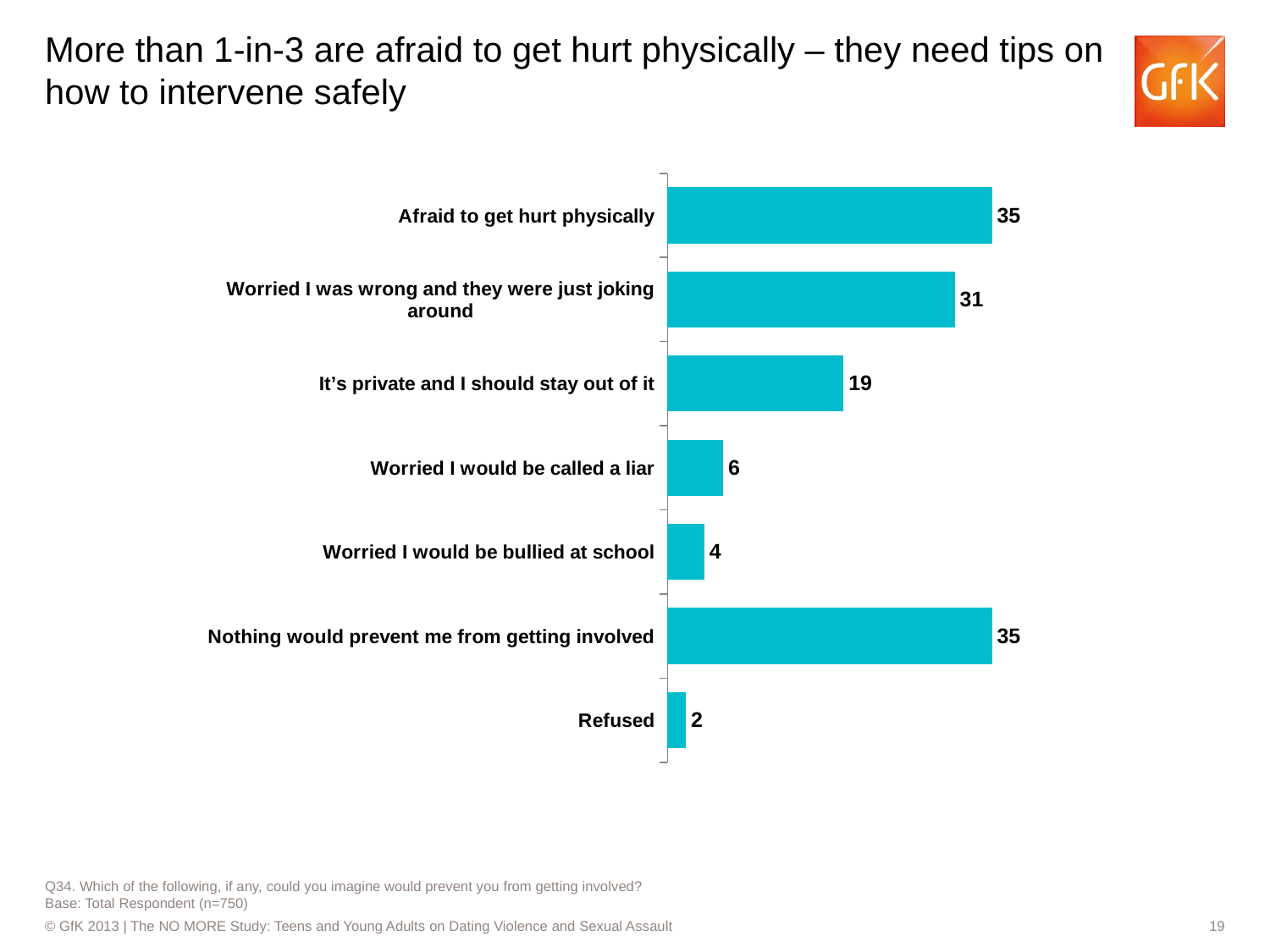
Which category has the lowest value? Refused What kind of chart is shown on the slide? Bar chart What is the value for "It's private and I should stay out of it"? 19 Which is larger: the value for "Worried I would be called a liar" or "Worried I would be bullied at school"? Worried I would be called a liar What is the difference between the values for "Afraid to get hurt physically" and "Worried I was wrong and they were just joking around"? 4 What is the value for "Worried I would be bullied at school"? 4 Which two categories share the same highest value of 35? Afraid to get hurt physically; Nothing would prevent me from getting involved What is the value for "Refused"? 2 What is the value for "Afraid to get hurt physically"? 35 How many categories are shown in the chart? 7 What is the difference between the values for "It's private and I should stay out of it" and "Worried I would be called a liar"? 13 What is the value for "Worried I was wrong and they were just joking around"? 31